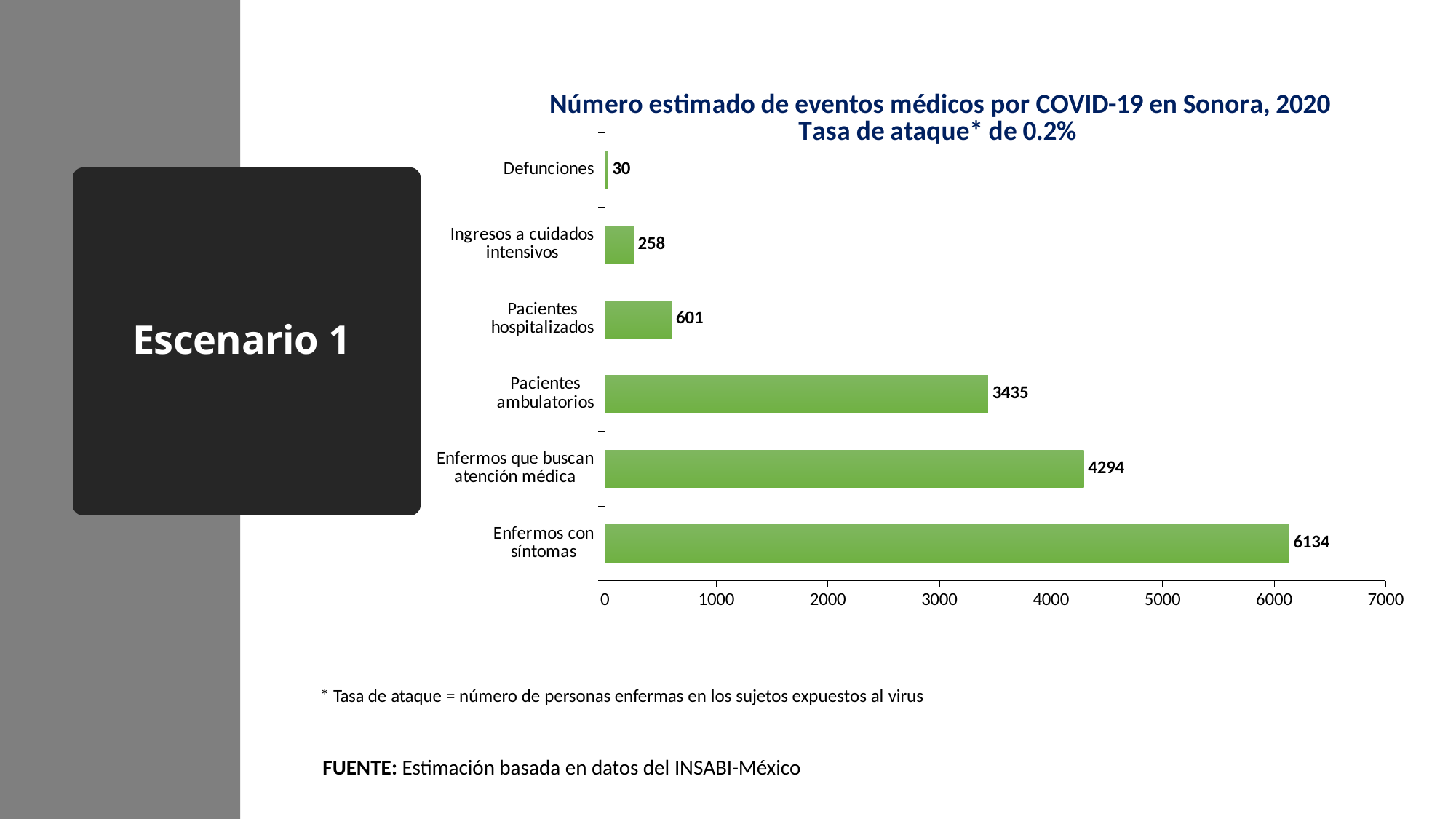
Which is larger, Pacientes ambulatorios or Pacientes hospitalizados? Pacientes ambulatorios What is the value for Pacientes hospitalizados? 601 What is the value for Enfermos que buscan atención médica? 4294 What is the difference between Enfermos con síntomas and Enfermos que buscan atención médica? 1840 Which category has the highest value? Enfermos con síntomas What kind of chart is shown on the slide? Bar chart Which category has the lowest value? Defunciones What is the value for Defunciones? 30 What is the difference between Pacientes hospitalizados and Ingresos a cuidados intensivos? 343 What is the value for Ingresos a cuidados intensivos? 258 How many categories are shown in the chart? 6 What attack rate (tasa de ataque) is stated in the chart title? 0.2%